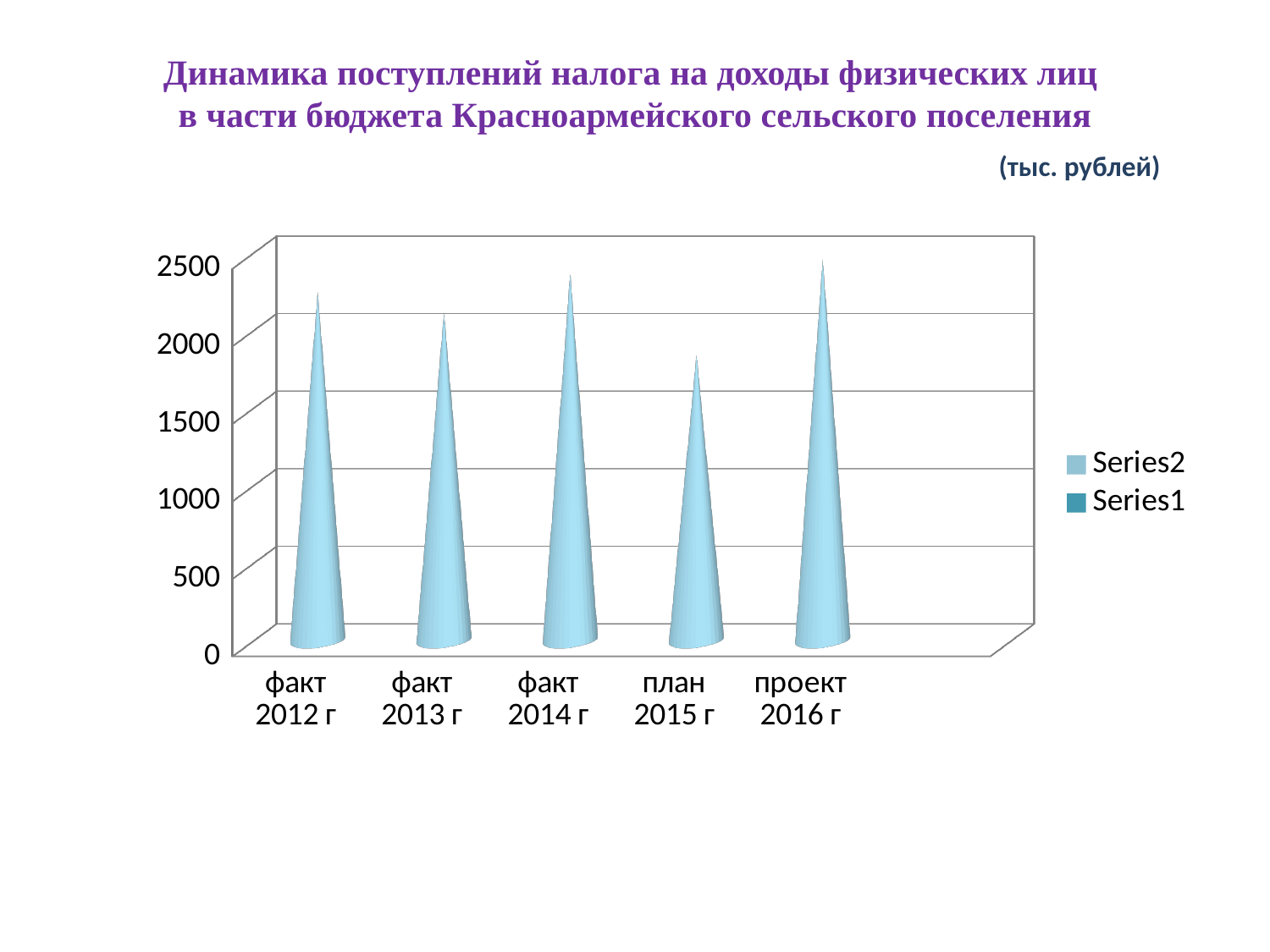
Is the value for проект 2016 г greater or less than 2000? greater What kind of chart is shown on the slide? bar chart How many categories are shown along the x axis of the chart? 5 How many series does the chart legend list? 2 In what units are the chart values given, according to the slide? тыс. рублей Which is larger, the value for факт 2014 г or the value for план 2015 г? факт 2014 г Is the value for план 2015 г greater or less than 2000? less Is the value for факт 2014 г greater or less than 2000? greater Which is larger, the value for проект 2016 г or the value for факт 2013 г? проект 2016 г Which category has the highest value in the chart? проект 2016 г Which category has the lowest value in the chart? план 2015 г